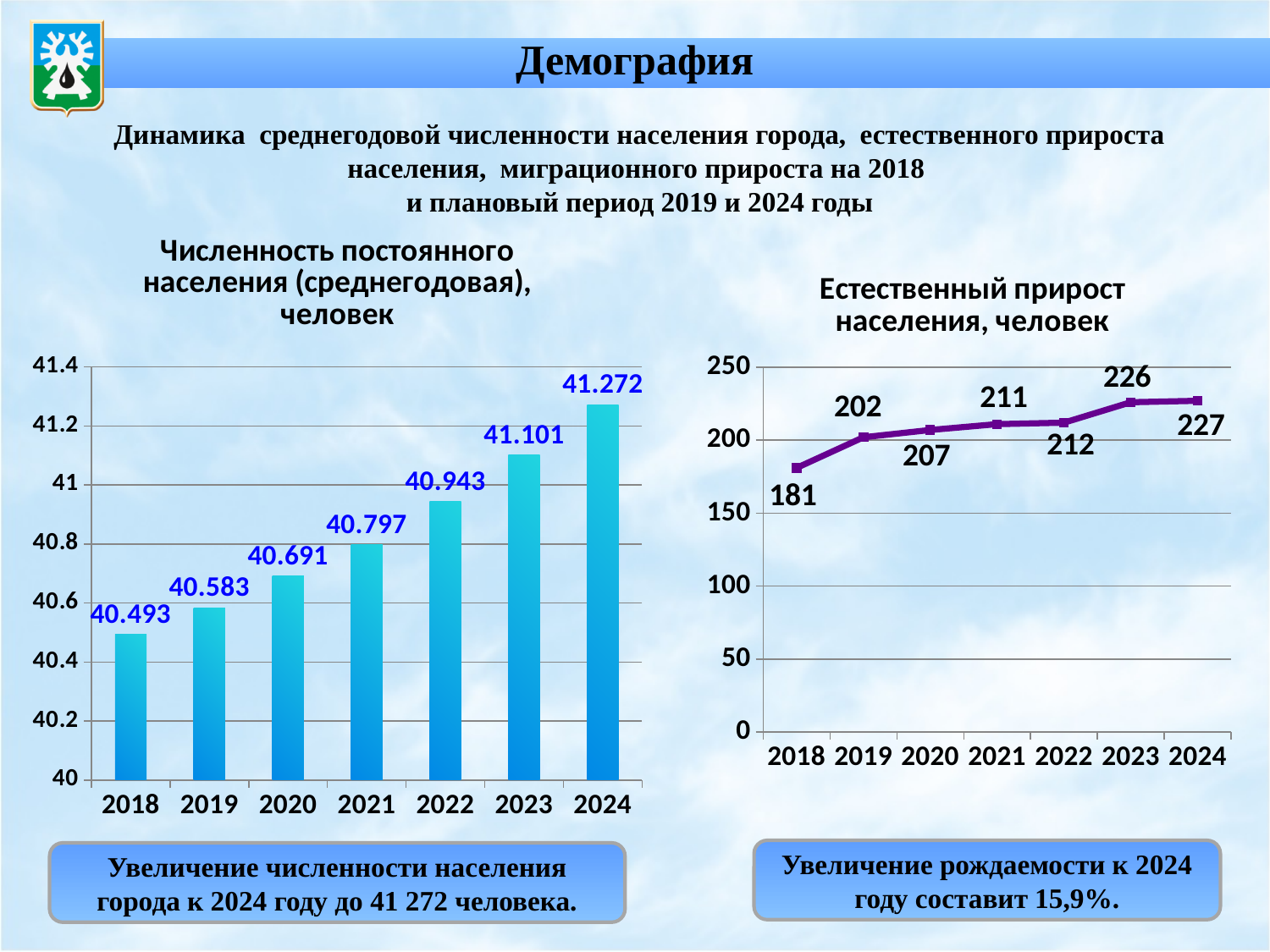
What kind of chart is 'Численность постоянного населения (среднегодовая), человек'? bar chart In the chart 'Естественный прирост населения, человек', what is the value for 2023? 226 In the chart 'Численность постоянного населения (среднегодовая), человек', how many bars are plotted? 7 In the chart 'Численность постоянного населения (среднегодовая), человек', what is the value for 2022? 40.943 In the chart 'Численность постоянного населения (среднегодовая), человек', which year has the highest value? 2024 In the chart 'Численность постоянного населения (среднегодовая), человек', what is the value for 2018? 40.493 In the chart 'Естественный прирост населения, человек', which year has the lowest value? 2018 In the chart 'Естественный прирост населения, человек', which is larger, the value for 2019 or the value for 2022? 2022 What kind of chart is 'Естественный прирост населения, человек'? line chart In the chart 'Численность постоянного населения (среднегодовая), человек', do the values rise or fall from 2018 to 2024? rise In the chart 'Естественный прирост населения, человек', what is the value for 2018? 181 In the chart 'Естественный прирост населения, человек', what is the difference between the values for 2024 and 2018? 46